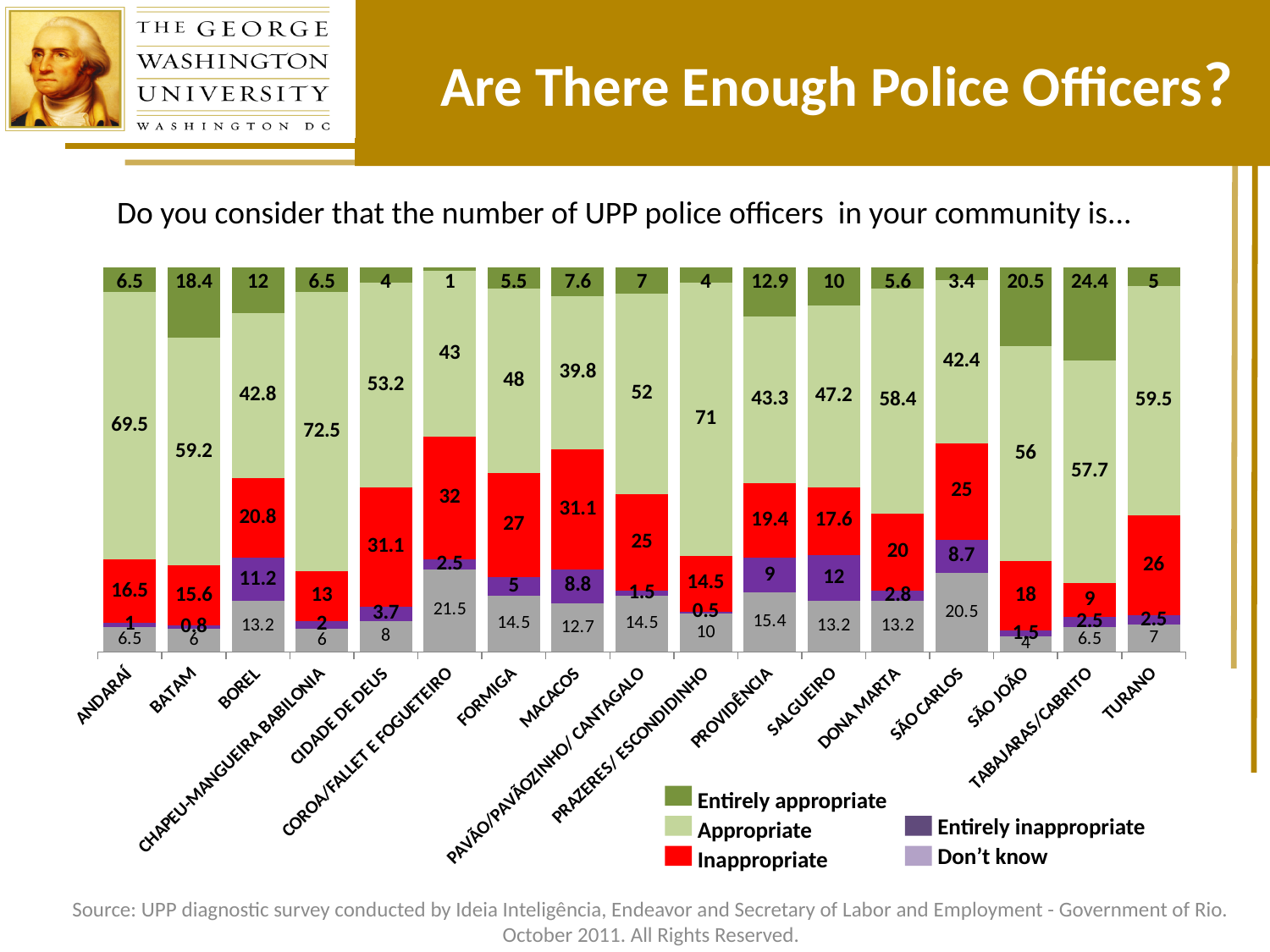
How many series does the legend list? 5 What kind of chart is shown on the slide? Stacked bar chart Which community has the lowest Appropriate value? MACACOS What is the total of the stacked bar for ANDARAÍ? 100 Which is larger: the Entirely inappropriate value for SALGUEIRO or for BOREL? SALGUEIRO What is the Appropriate value for CHAPEU-MANGUEIRA BABILONIA? 72.5 Which community has the highest Entirely appropriate value? TABAJARAS/CABRITO What is the Don't know value for COROA/FALLET E FOGUETEIRO? 21.5 What is the difference between the Appropriate values for ANDARAÍ and BATAM? 10.3 How many communities are shown on the x axis? 17 Which community has the highest Inappropriate value? COROA/FALLET E FOGUETEIRO What percentage of respondents in BOREL said the number of UPP police officers is Inappropriate? 20.8